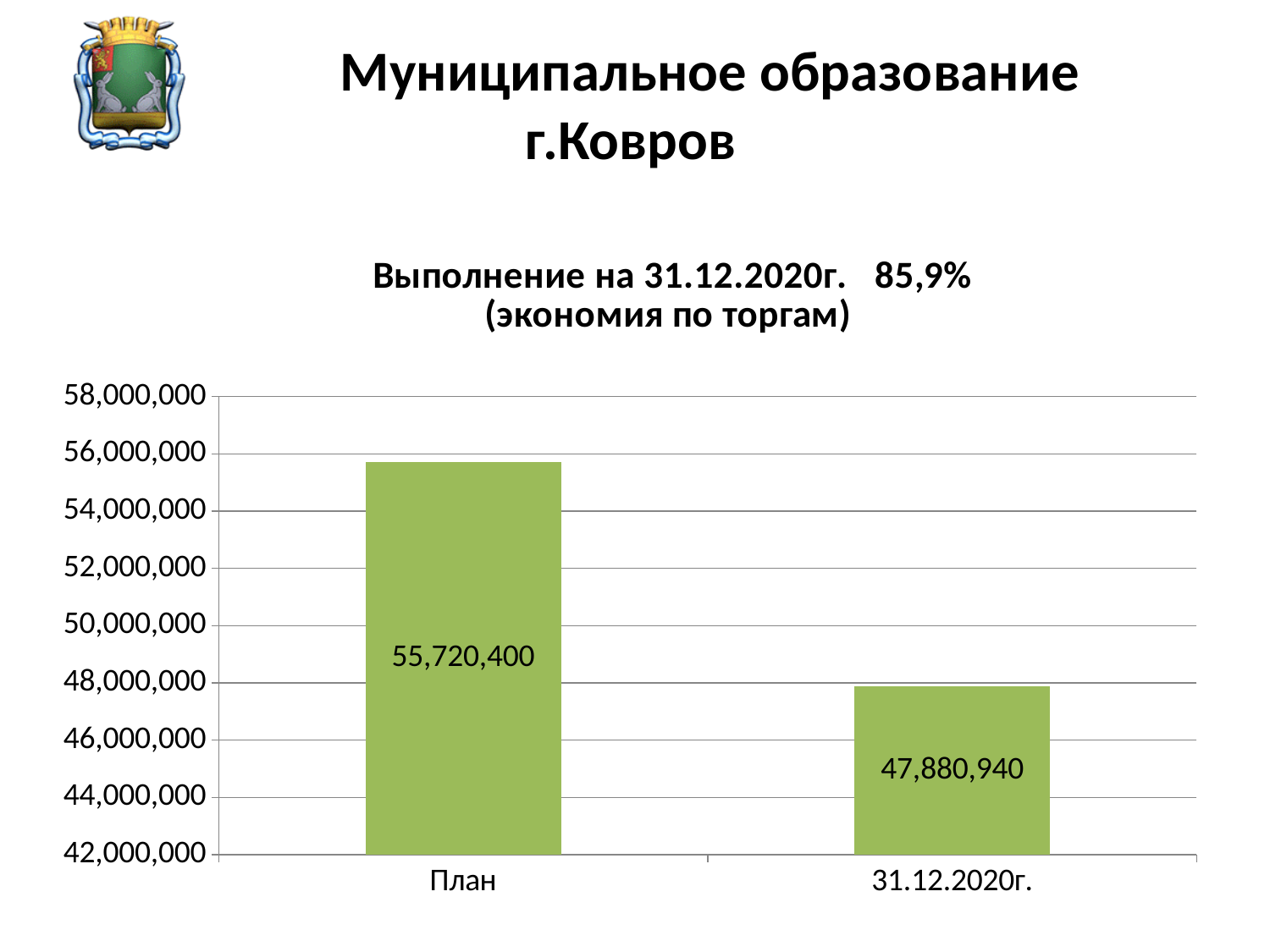
Is the value for План greater or less than 54,000,000? greater How many categories are shown on the x axis? 2 What is the value for План? 55,720,400 What is the difference between the value for План and the value for 31.12.2020г.? 7,839,460 Which category has the highest value? План What percentage is shown in the chart title? 85,9% What is the value for 31.12.2020г.? 47,880,940 Which category has the lowest value? 31.12.2020г. Do the values rise or fall from План to 31.12.2020г.? fall What kind of chart is shown on the slide? bar chart Is the value for 31.12.2020г. greater or less than 50,000,000? less Which is larger, the value for План or the value for 31.12.2020г.? План